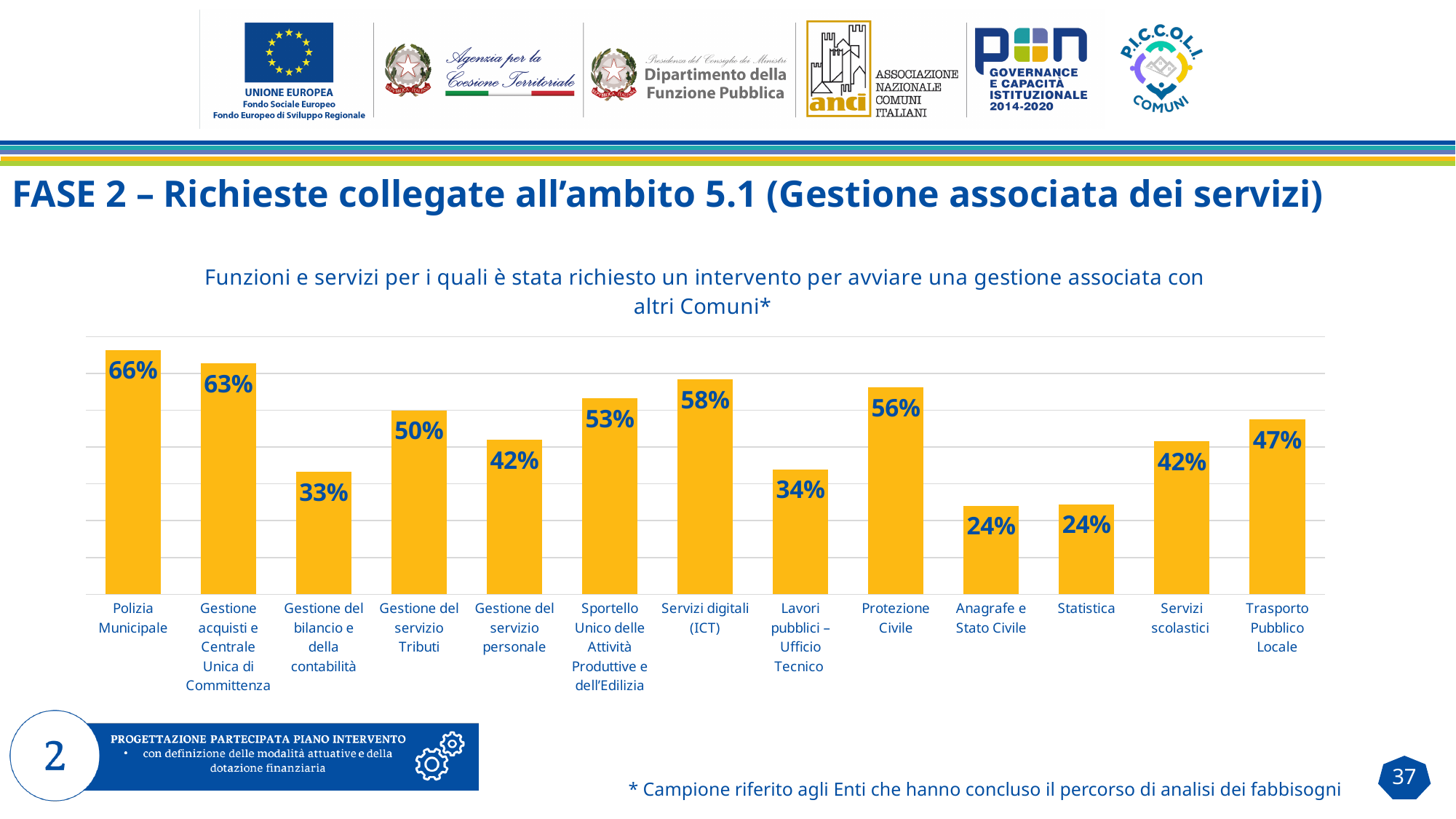
What is the value for Trasporto Pubblico Locale? 47% What is the value for Statistica? 24% What kind of chart is shown on the slide? Bar chart What is the value for Servizi digitali (ICT)? 58% Which category has the highest value? Polizia Municipale How many categories are shown in the chart? 13 What is the value for Polizia Municipale? 66% What is the difference between the values for Polizia Municipale and Gestione del servizio Tributi? 16% What is the value for Protezione Civile? 56% What is the difference between the values for Servizi digitali (ICT) and Lavori pubblici – Ufficio Tecnico? 24% Which is larger, the value for Gestione del bilancio e della contabilità or the value for Gestione del servizio personale? Gestione del servizio personale What colour are the bars in the chart? Yellow